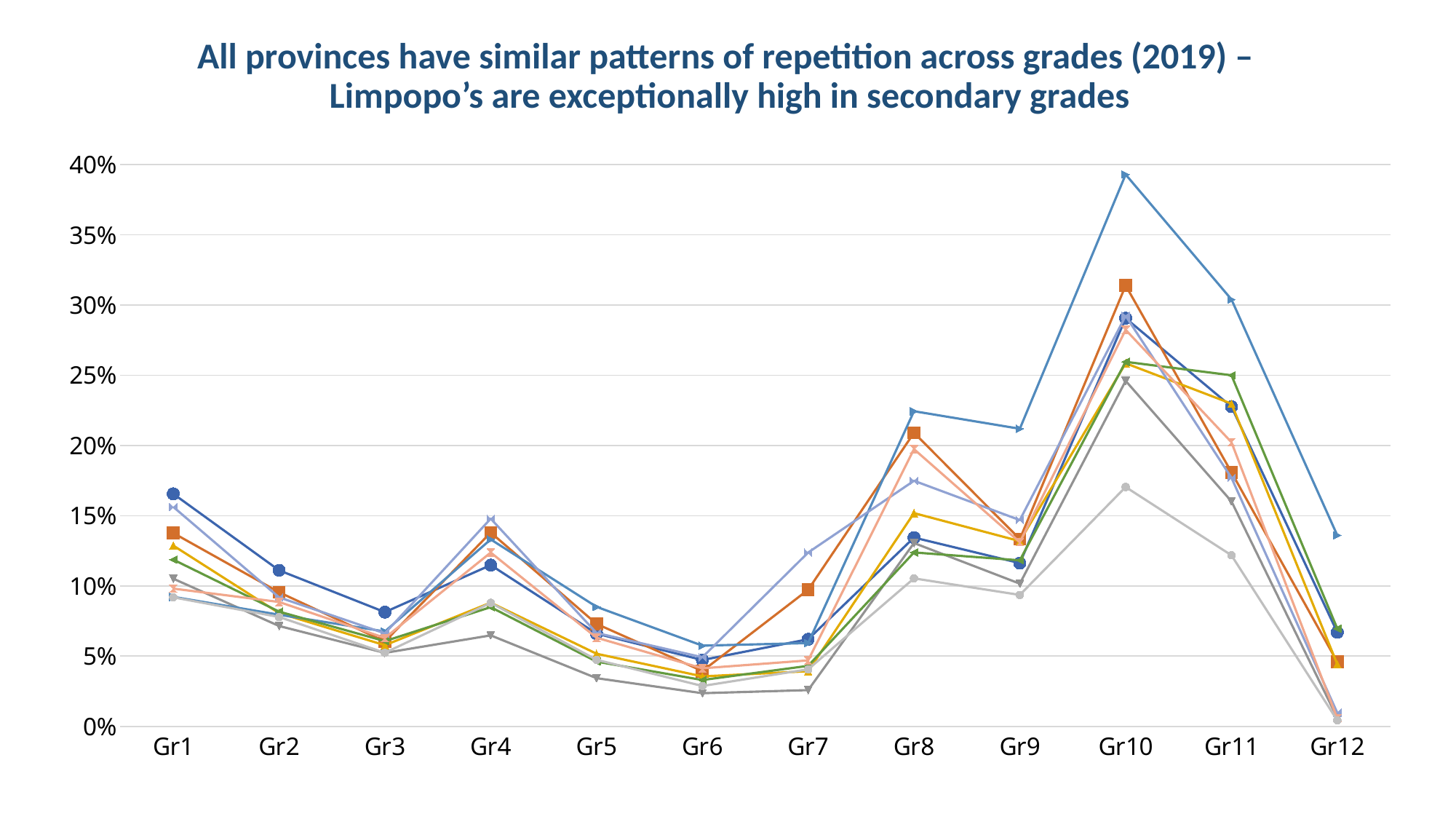
What is the highest tick value shown on the y axis? 40% At which grade does the highest line reach its peak? Gr10 Is the lowest value plotted at Gr6 greater or less than 5%? less Is the highest value plotted at Gr12 greater or less than 15%? less What is the title of the chart? All provinces have similar patterns of repetition across grades (2019) – Limpopo's are exceptionally high in secondary grades Do the lines rise or fall from Gr3 to Gr4? rise Is the highest value plotted at Gr10 greater or less than 35%? greater What kind of chart is shown on the slide? line chart How many grade categories are shown on the x axis? 12 Do the lines rise or fall from Gr10 to Gr12? fall Do the lines rise or fall from Gr1 to Gr3? fall